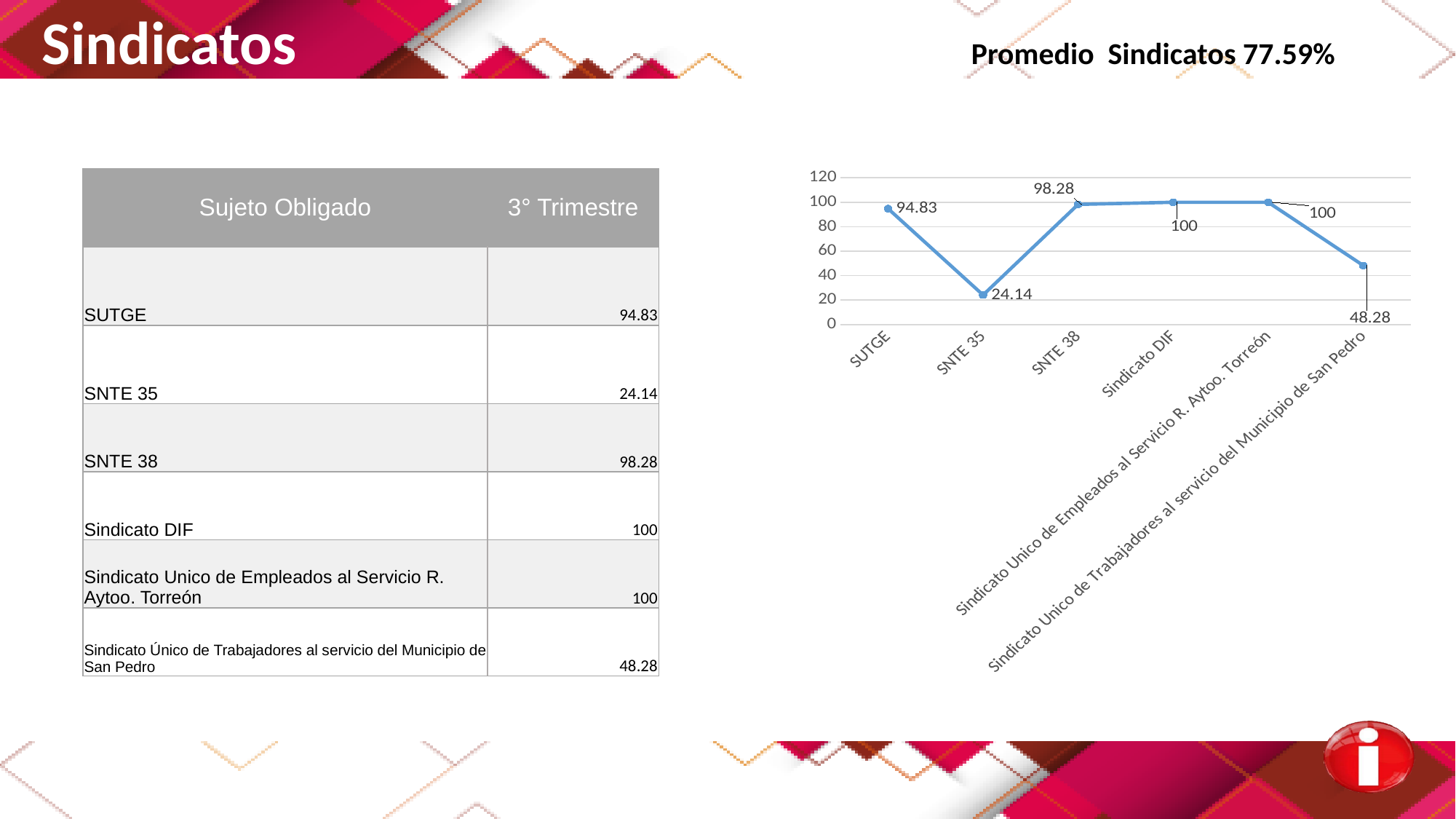
Is the value for SNTE 35 greater or less than 40? less What is the value for Sindicato DIF in the line chart? 100 How many categories are plotted on the x axis of the line chart? 6 What is the value for SNTE 35 in the line chart? 24.14 Which is larger, the value for SUTGE or the value for Sindicato Unico de Trabajadores al servicio del Municipio de San Pedro? SUTGE What is the value for SUTGE in the line chart? 94.83 Which category has the lowest value in the line chart? SNTE 35 What is the difference between the values for SNTE 38 and SNTE 35? 74.14 What is the value for SNTE 38 in the line chart? 98.28 What is the value for Sindicato Unico de Trabajadores al servicio del Municipio de San Pedro in the line chart? 48.28 What is the difference between the values for Sindicato DIF and SUTGE? 5.17 What type of chart is shown on the slide? line chart